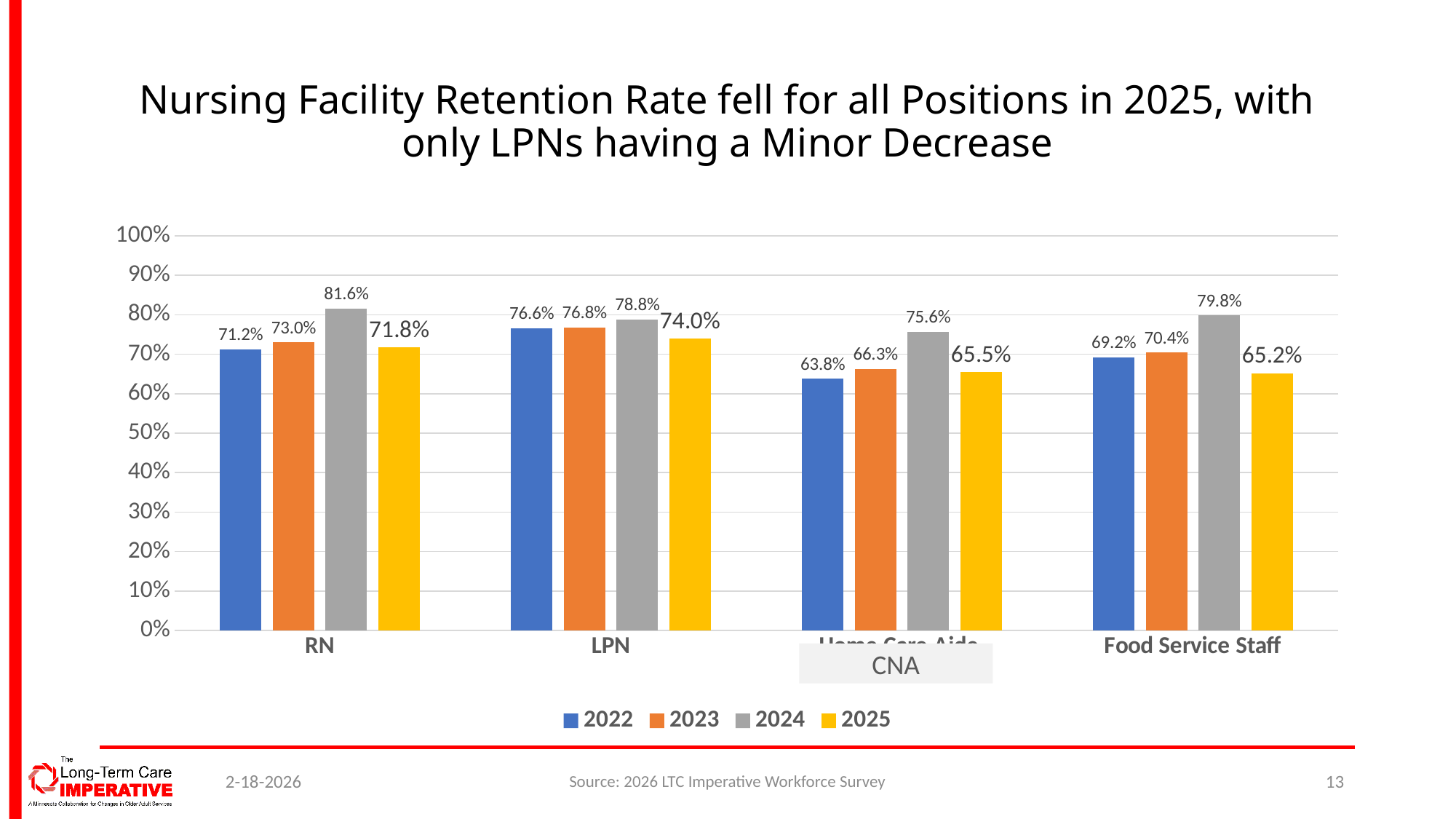
By how many percentage points did the RN retention rate fall from 2024 to 2025? 9.8 percentage points Which had a higher retention rate in 2023, RN or LPN? LPN How many years does the legend list? 4 What type of chart is shown on the slide? Bar chart What is the retention rate for LPN in 2025? 74.0% Which position had the highest retention rate in 2024? RN How many position categories are shown on the x axis? 4 Is the 2025 retention rate for Food Service Staff greater or less than 70%? less Which position had the lowest retention rate in 2025? Food Service Staff What is the retention rate for Food Service Staff in 2022? 69.2% What is the retention rate for RN in 2024? 81.6% What is the difference between the LPN retention rate in 2024 and in 2025? 4.8 percentage points